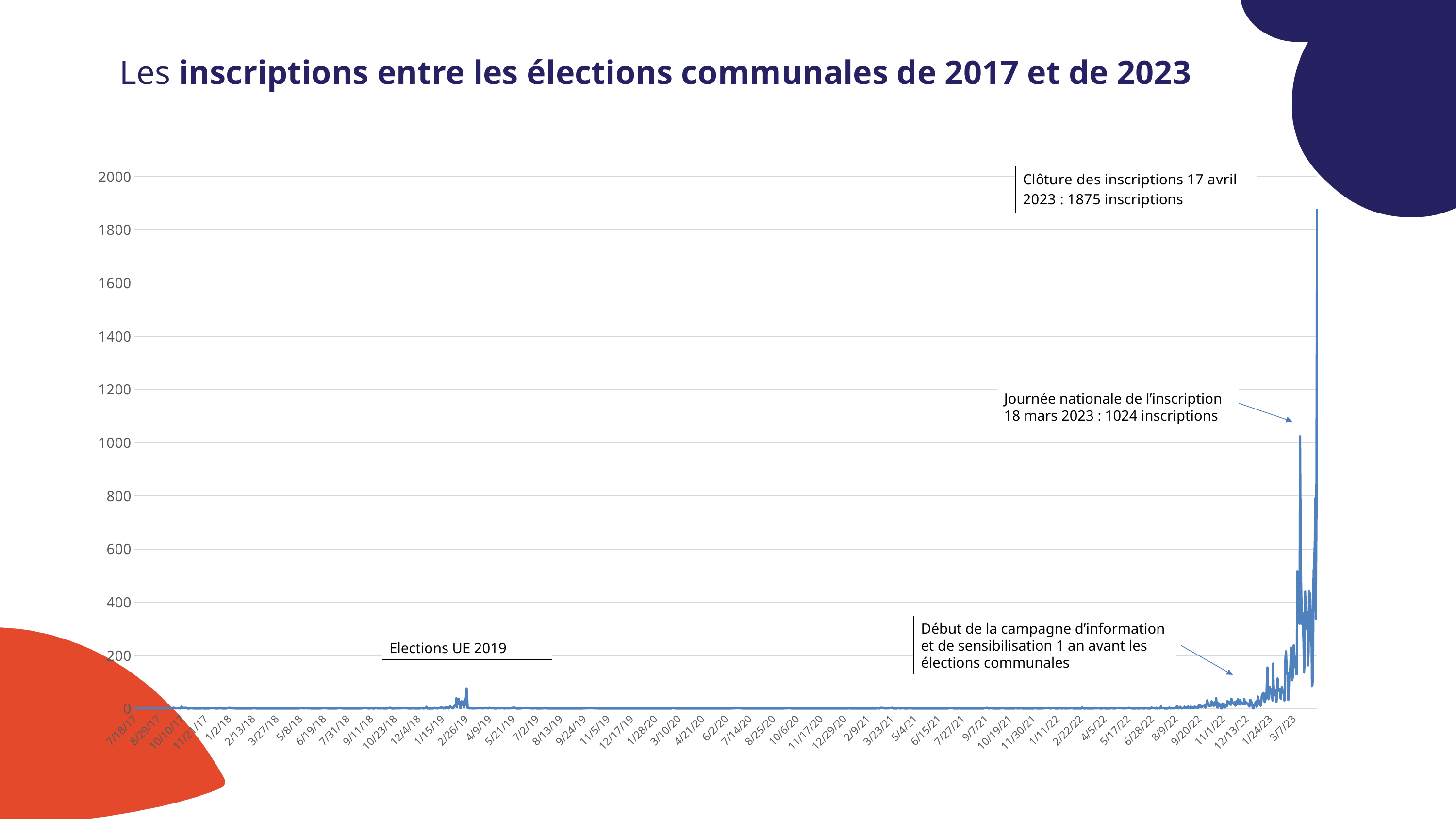
Is the peak of inscriptions around the Elections UE 2019 greater or less than 200? less Is the value at the closing of registrations on 17 April 2023 greater or less than 1800? greater Which had more inscriptions: the closing of registrations on 17 April 2023 or the Journée nationale de l'inscription on 18 March 2023? Clôture des inscriptions 17 avril 2023 What is the difference between the inscriptions at the closing on 17 April 2023 and those on 18 March 2023? 851 What is the highest value reached by the line on the chart? 1875 Do the inscriptions generally rise or fall toward the end of the x axis in 2023? rise What is the first date label shown on the x axis of the chart? 7/18/17 How many inscriptions were recorded on the Journée nationale de l'inscription, 18 March 2023? 1024 inscriptions How many inscriptions were recorded at the closing of registrations on 17 April 2023? 1875 inscriptions What kind of chart is shown on the slide? line chart What is the title of the chart on the slide? Les inscriptions entre les élections communales de 2017 et de 2023 What is the highest value shown on the y axis of the chart? 2000